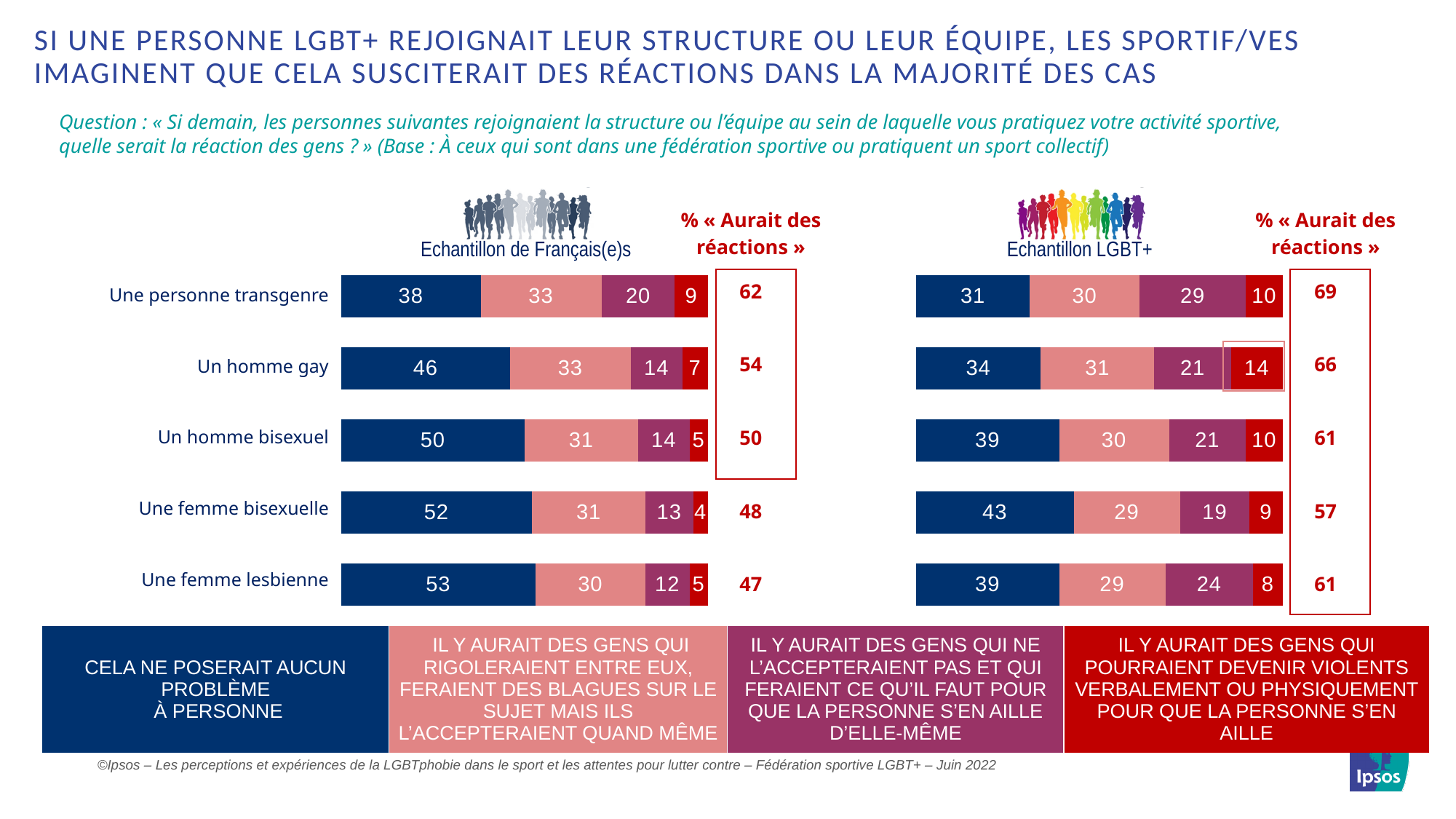
What is the difference between the '% « Aurait des réactions »' for 'Une personne transgenre' in the 'Echantillon LGBT+' chart and in the 'Echantillon de Français(e)s' chart? 7 What type of chart is used for the 'Echantillon de Français(e)s' data? Stacked bar chart Which colour represents the response 'Il y aurait des gens qui pourraient devenir violents verbalement ou physiquement pour que la personne s'en aille'? Red In the 'Echantillon de Français(e)s' chart, what is the '% « Aurait des réactions »' value for 'Un homme bisexuel'? 50 In the 'Echantillon de Français(e)s' chart, which is larger: the dark blue segment for 'Une femme lesbienne' or for 'Un homme gay'? Une femme lesbienne How many response categories does the legend at the bottom of the slide list? 4 In the 'Echantillon LGBT+' chart, which category has the lowest '% « Aurait des réactions »' value? Une femme bisexuelle In the 'Echantillon de Français(e)s' chart, which category has the highest '% « Aurait des réactions »' value? Une personne transgenre In the 'Echantillon de Français(e)s' chart, what percentage say it would pose no problem to anyone ('Cela ne poserait aucun problème à personne') for 'Une personne transgenre'? 38 In the 'Echantillon LGBT+' chart, what is the value of the red segment (people who could become violent) for 'Un homme gay'? 14 How many categories (types of person) are shown in the 'Echantillon LGBT+' chart? 5 In the 'Echantillon LGBT+' chart, what is the total of the segments for 'Une femme bisexuelle'? 100